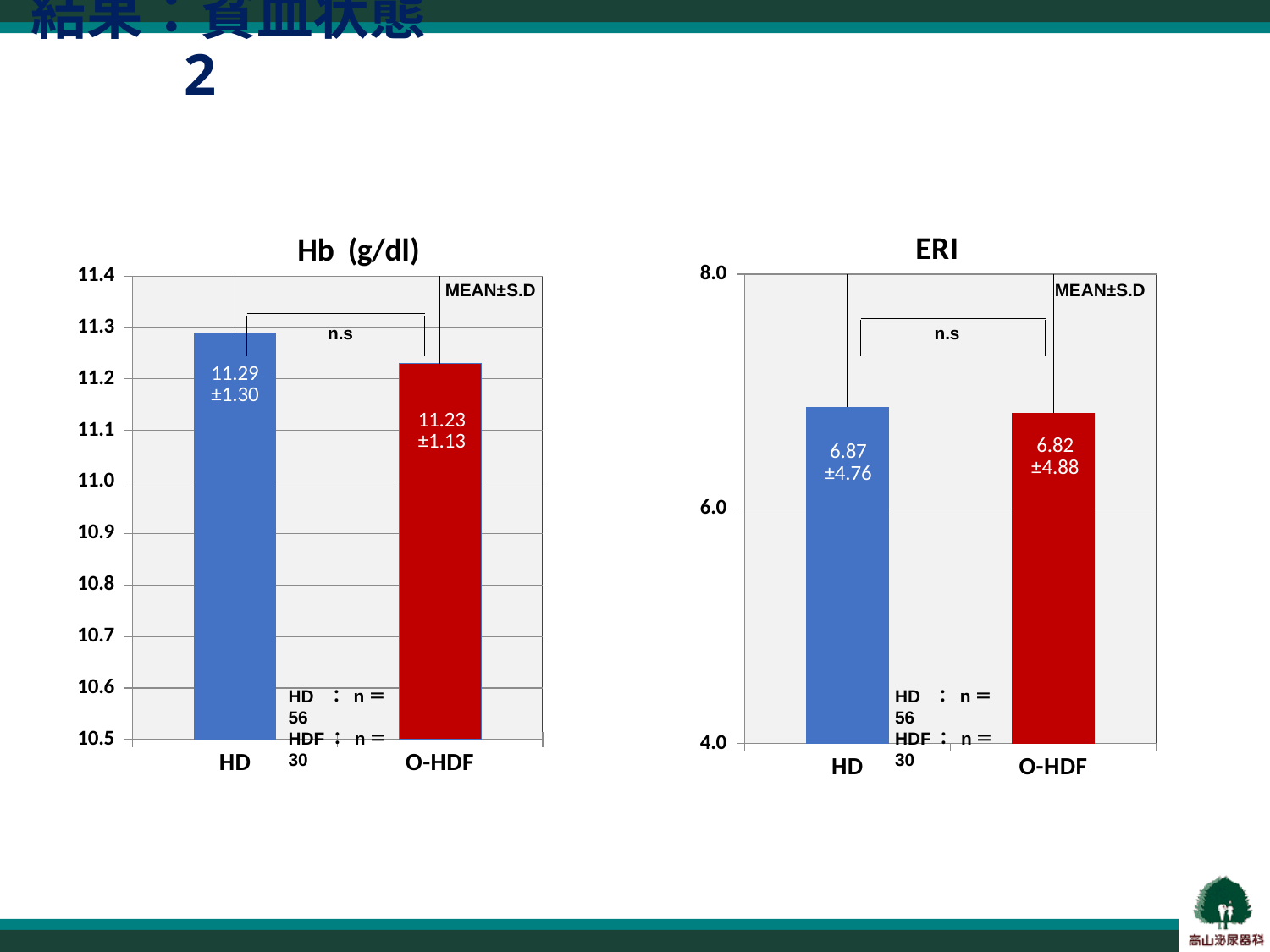
In the ERI chart, what is the standard deviation shown for HD? ±4.76 In the Hb (g/dl) chart, what is the mean value for HD? 11.29 In the ERI chart, what is the difference between the mean values for HD and O-HDF? 0.05 In the Hb (g/dl) chart, what is the difference between the mean values for HD and O-HDF? 0.06 In the Hb (g/dl) chart, which group has the higher mean value? HD In the ERI chart, what is the mean value for HD? 6.87 In the Hb (g/dl) chart, what is the mean value for O-HDF? 11.23 In the Hb (g/dl) chart, what is the standard deviation shown for O-HDF? ±1.13 In the ERI chart, what is the mean value for O-HDF? 6.82 In the ERI chart, which group has the lower mean value? O-HDF What kind of chart is the ERI chart? Bar chart How many categories are shown on the x axis of the Hb (g/dl) chart? 2